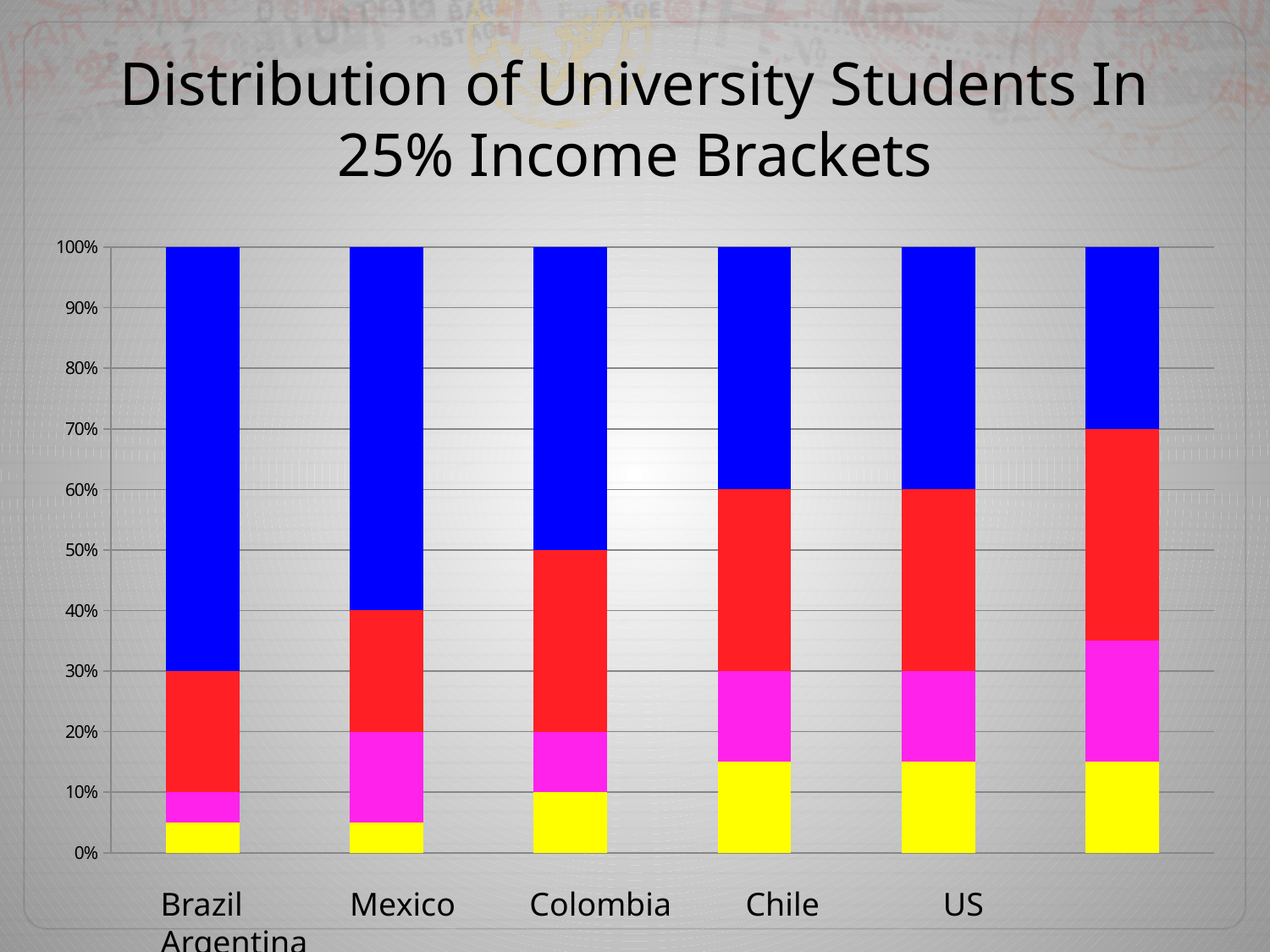
Is the boundary between the red and blue segments for Mexico greater or less than 50%? less How many coloured segments make up each bar? 4 Is the top of the yellow segment for Mexico greater or less than 10%? less At what percentage does the blue segment of the Colombia bar begin? 50% At what percentage does the blue segment of the Chile bar begin? 60% How many bars are plotted in the chart? 6 What is the title of the chart? Distribution of University Students In 25% Income Brackets At what percentage does the blue segment of the Brazil bar begin? 30% Does the size of the blue segment rise or fall from Brazil to US along the x axis? fall Which labelled country has the largest blue segment? Brazil What kind of chart is shown on the slide? Stacked bar chart Is the yellow segment larger for Chile or for Brazil? Chile